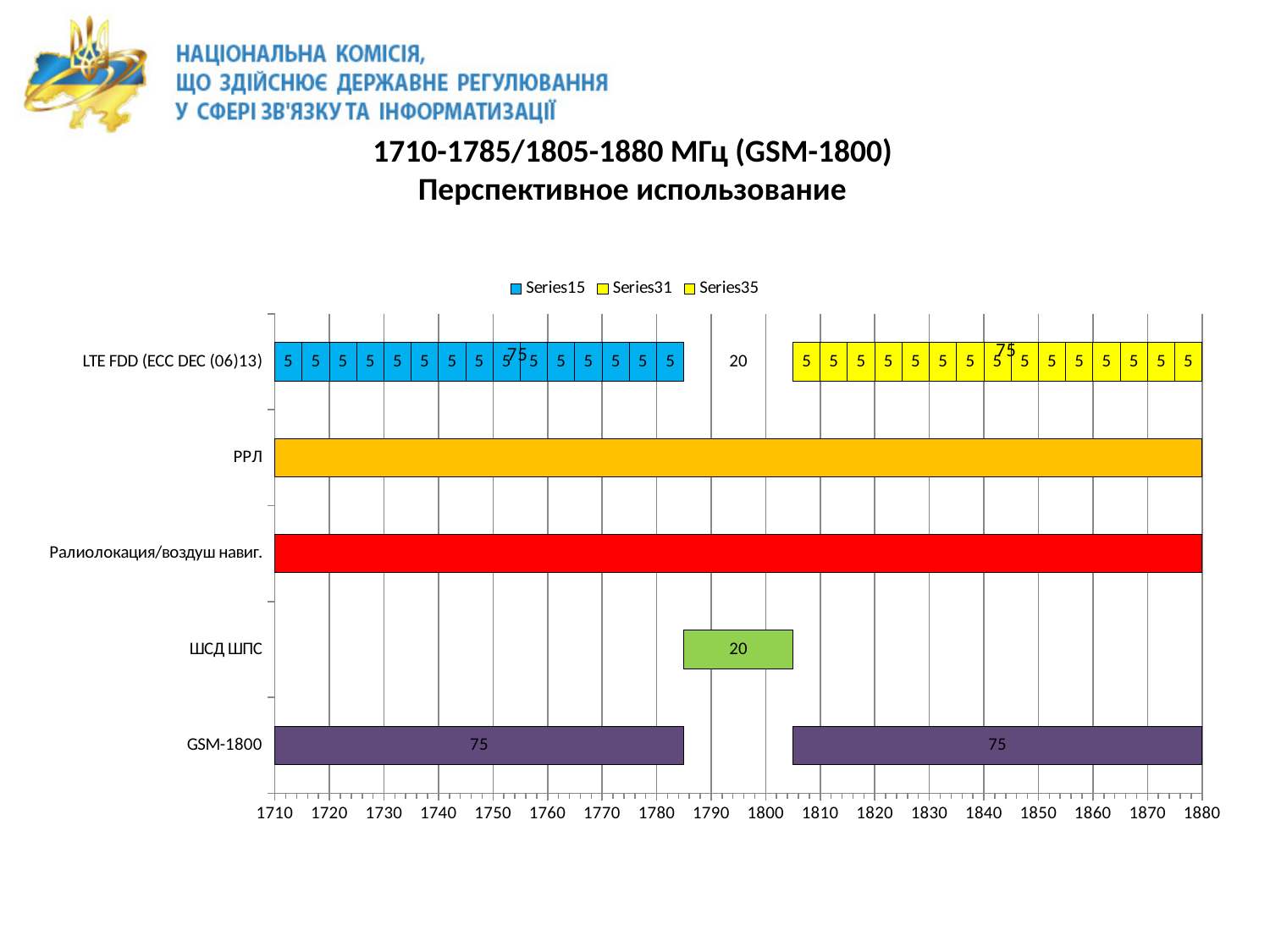
What kind of chart is shown on the slide? bar chart What are the lowest and highest values shown on the horizontal axis? 1710 and 1880 What value is printed on the ШСД ШПС bar? 20 How many categories are listed on the vertical axis of the chart? 5 Which is larger: a GSM-1800 segment (75) or the ШСД ШПС segment (20)? GSM-1800 What value is printed on the right GSM-1800 bar? 75 What value is printed in the gap between the two groups of blocks in the LTE FDD (ECC DEC (06)13) row? 20 What is the difference between a GSM-1800 segment value (75) and the ШСД ШПС value (20)? 55 What value is printed on the left GSM-1800 bar? 75 What are the three entries in the chart legend? Series15, Series31, Series35 What is the total of the two labelled GSM-1800 bar segments? 150 How many series does the chart legend list? 3